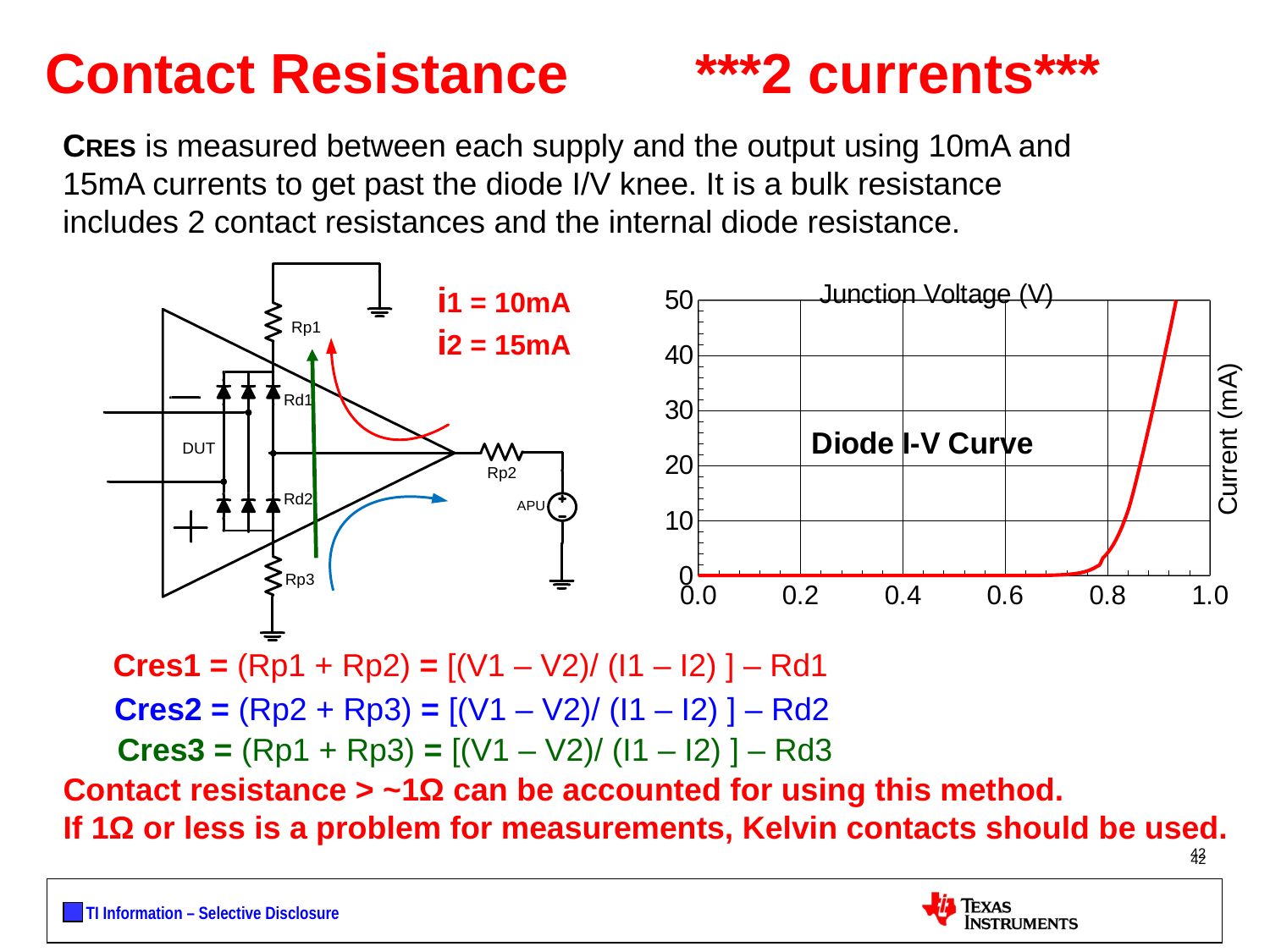
What kind of chart is the Diode I-V Curve? line chart In the Diode I-V Curve chart, is the current at a junction voltage of 0.9 V greater or less than 20 mA? greater In the Diode I-V Curve chart, is the current at a junction voltage of 0.8 V greater or less than 10 mA? less In the Diode I-V Curve chart, which junction voltage has the higher current, 0.8 V or 0.9 V? 0.9 V What is the maximum value shown on the y axis of the Diode I-V Curve chart? 50 In the Diode I-V Curve chart, is the current at a junction voltage of 0.6 V greater or less than 10 mA? less What is the label of the x axis of the Diode I-V Curve chart? Junction Voltage (V) What is the title of the chart on the right side of the slide? Diode I-V Curve In the Diode I-V Curve chart, does the current rise or fall as junction voltage increases along the x axis? rise